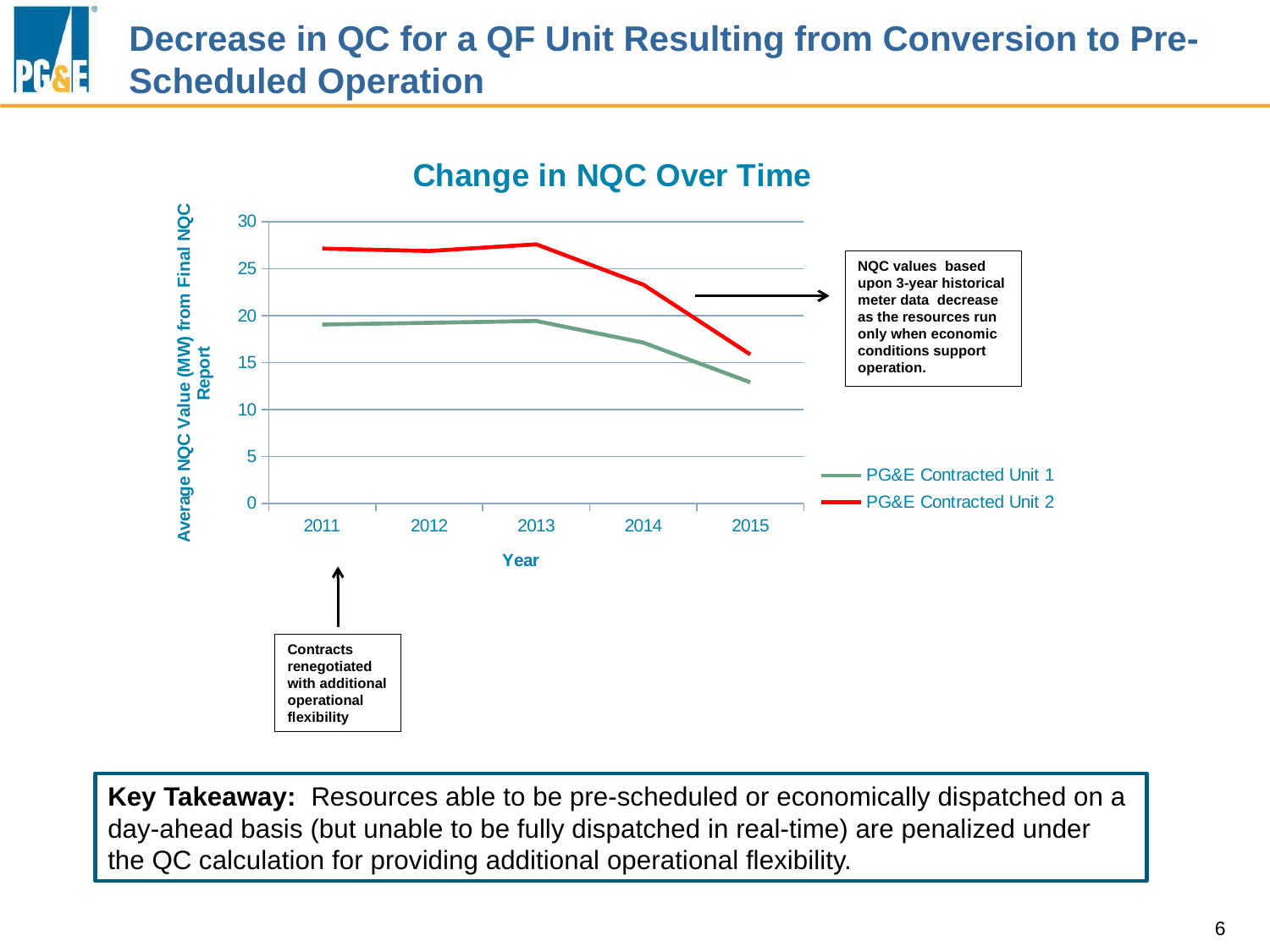
Is the value for PG&E Contracted Unit 2 in 2014 greater or less than 25? less In which year is the value for PG&E Contracted Unit 2 lowest? 2015 Is the value for PG&E Contracted Unit 2 in 2011 greater or less than 25? greater How many years are plotted along the x axis? 5 What is the title of the chart? Change in NQC Over Time What kind of chart is shown on the slide? line chart In 2014, which series has the larger value, PG&E Contracted Unit 1 or PG&E Contracted Unit 2? PG&E Contracted Unit 2 Do the values for PG&E Contracted Unit 1 rise or fall from 2013 to 2015? fall How many series does the legend list? 2 What colour is the line for PG&E Contracted Unit 2? red Is the value for PG&E Contracted Unit 1 in 2015 greater or less than 15? less